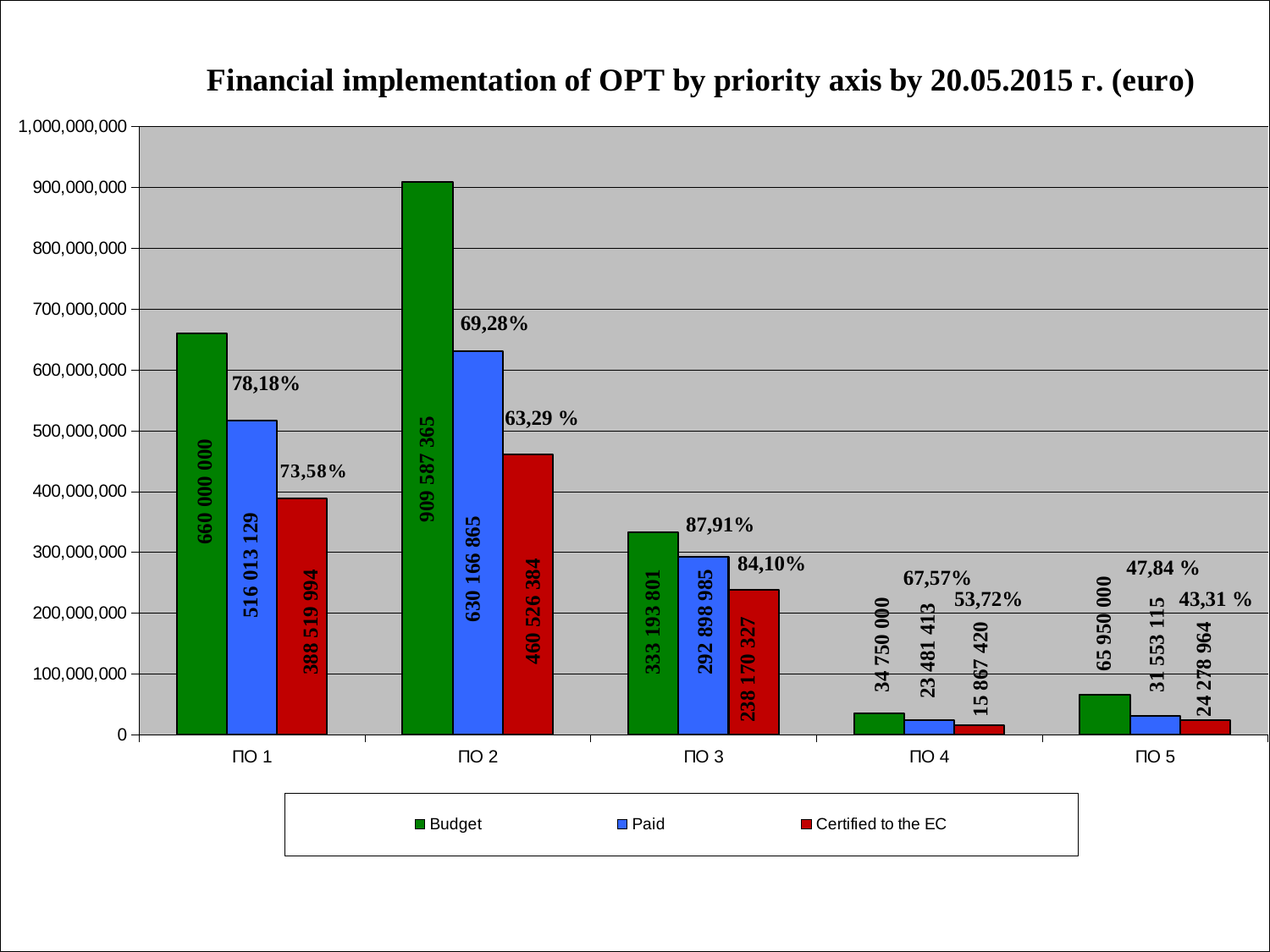
Which priority axis has the highest Budget? ПО 2 How many priority axes (categories) are shown on the x axis? 5 What is the Certified to the EC value for ПО 5? 24 278 964 What is the Budget value for ПО 2? 909 587 365 What is the Paid value for ПО 3? 292 898 985 What is the difference between the Budget and the Paid value for ПО 1? 143 986 871 How many series does the legend list? 3 Is the Budget value for ПО 3 greater or less than 300,000,000? greater What kind of chart is shown on the slide? bar chart Which priority axis has the lowest Budget? ПО 4 Which colour represents the Certified to the EC series in the legend? red Which is larger, the Paid value for ПО 4 or the Paid value for ПО 5? ПО 5